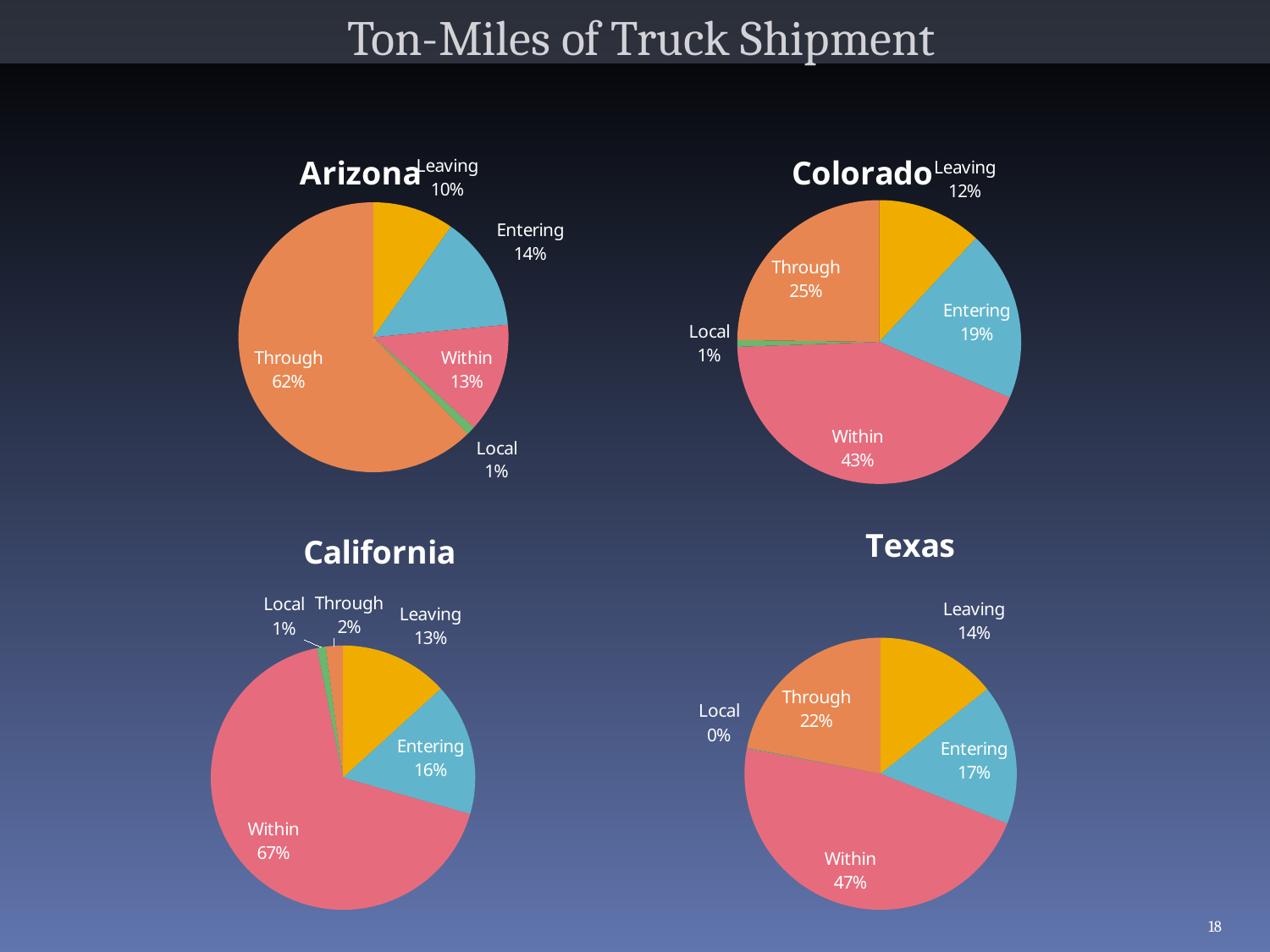
In the Colorado chart, what is the difference between the Within and Through shares? 18% In the Arizona chart, which category has the largest share? Through What kind of chart is the California chart? Pie chart In the Texas chart, which is larger, Leaving or Entering? Entering In the California chart, which category has the smallest share? Local In the Arizona chart, what share of ton-miles is Through? 62% In the Texas chart, which category has the largest share? Within How many categories does the Colorado chart show? 5 What is the title of the slide? Ton-Miles of Truck Shipment In the Texas chart, what share of ton-miles is Through? 22% In the Colorado chart, what share of ton-miles is Within? 43% In the California chart, what share of ton-miles is Entering? 16%